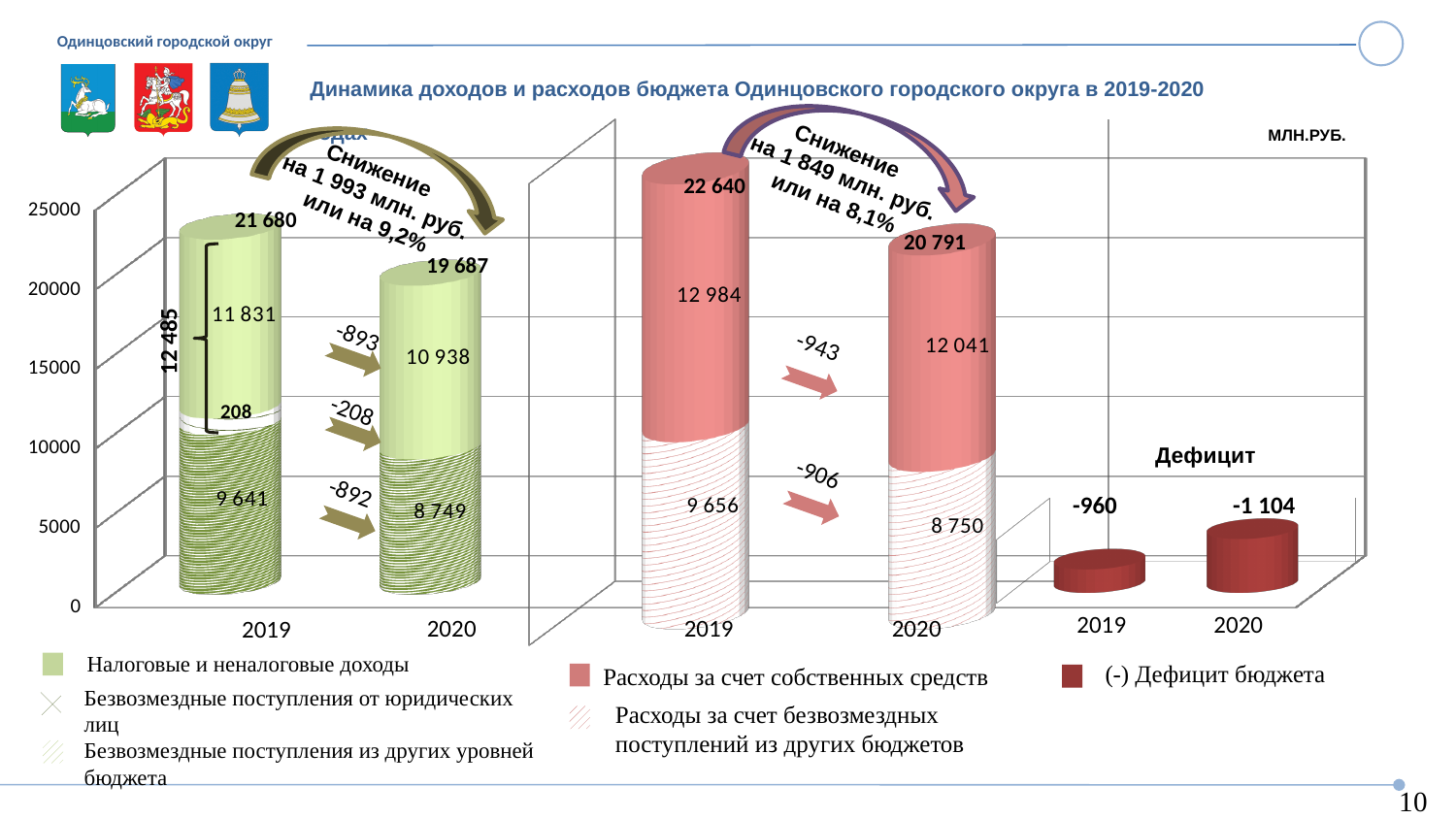
What was the total budget income (доходы) in 2020? 19 687 What was the total budget income (доходы) in 2019? 21 680 By how much did total expenditure decrease from 2019 to 2020, according to the annotation? на 1 849 млн. руб. или на 8,1% What was the value of 'Налоговые и неналоговые доходы' in 2020? 10 938 What was the total budget expenditure (расходы) in 2019? 22 640 Which year had the larger total budget income, 2019 or 2020? 2019 Did total budget income rise or fall from 2019 to 2020? fall What is the difference between 'Расходы за счет безвозмездных поступлений из других бюджетов' in 2019 (9 656) and 2020 (8 750)? 906 What was the total budget expenditure (расходы) in 2020? 20 791 What was the value of 'Расходы за счет собственных средств' in 2019? 12 984 What was the budget deficit (Дефицит) in 2020? -1 104 In what units are the values on the chart given? млн.руб.